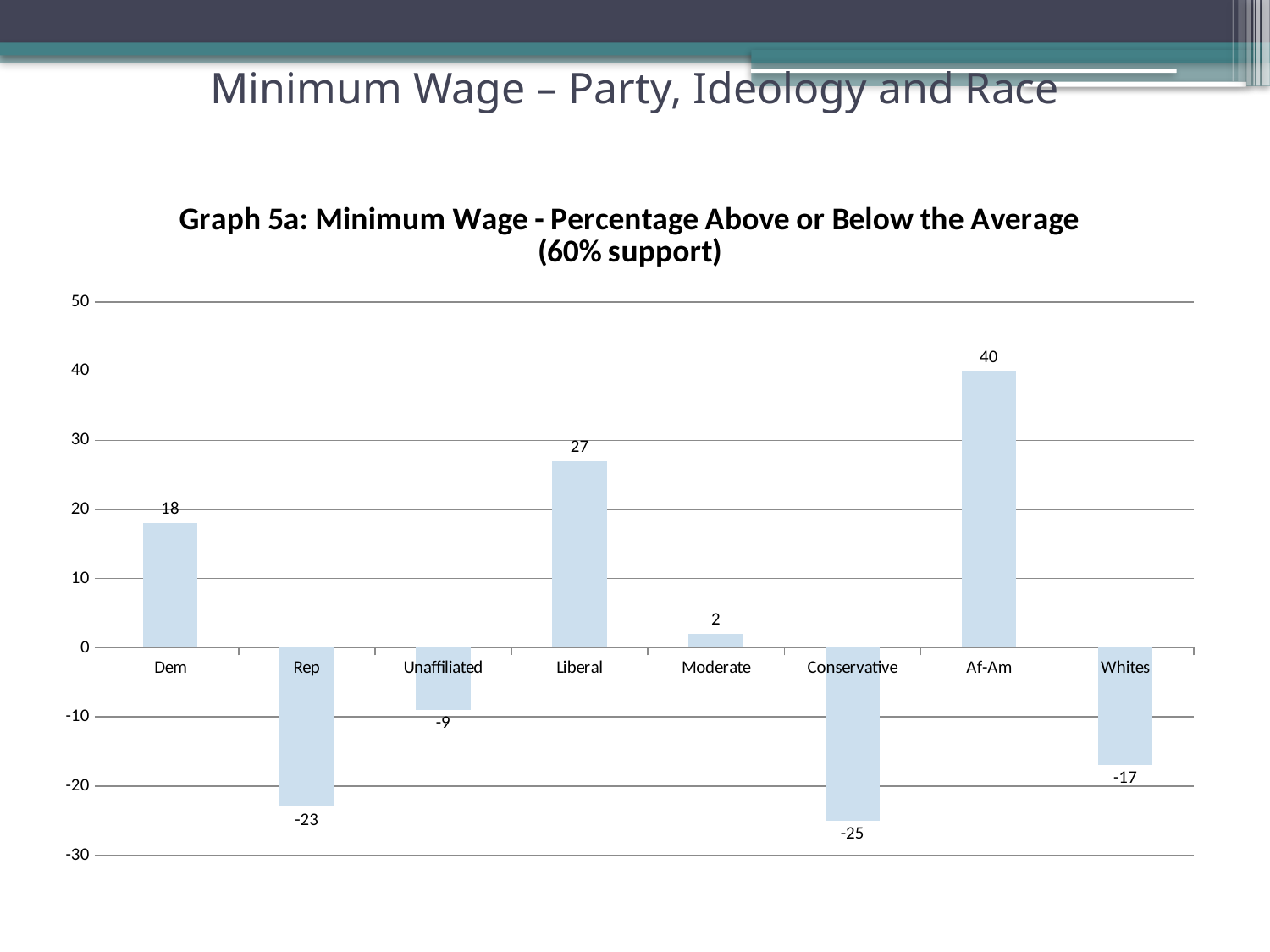
Which has a larger value, Dem or Liberal? Liberal What kind of chart is shown on the slide? Bar chart How many categories are shown on the x axis? 8 What is the value for Whites? -17 What is the value for Rep? -23 What is the value for Moderate? 2 Which category has the highest value? Af-Am What is the value for Af-Am? 40 Which category has the lowest value? Conservative What is the title of the chart? Graph 5a: Minimum Wage - Percentage Above or Below the Average (60% support) What is the difference between the values for Liberal and Dem? 9 What is the difference between the values for Af-Am and Conservative? 65